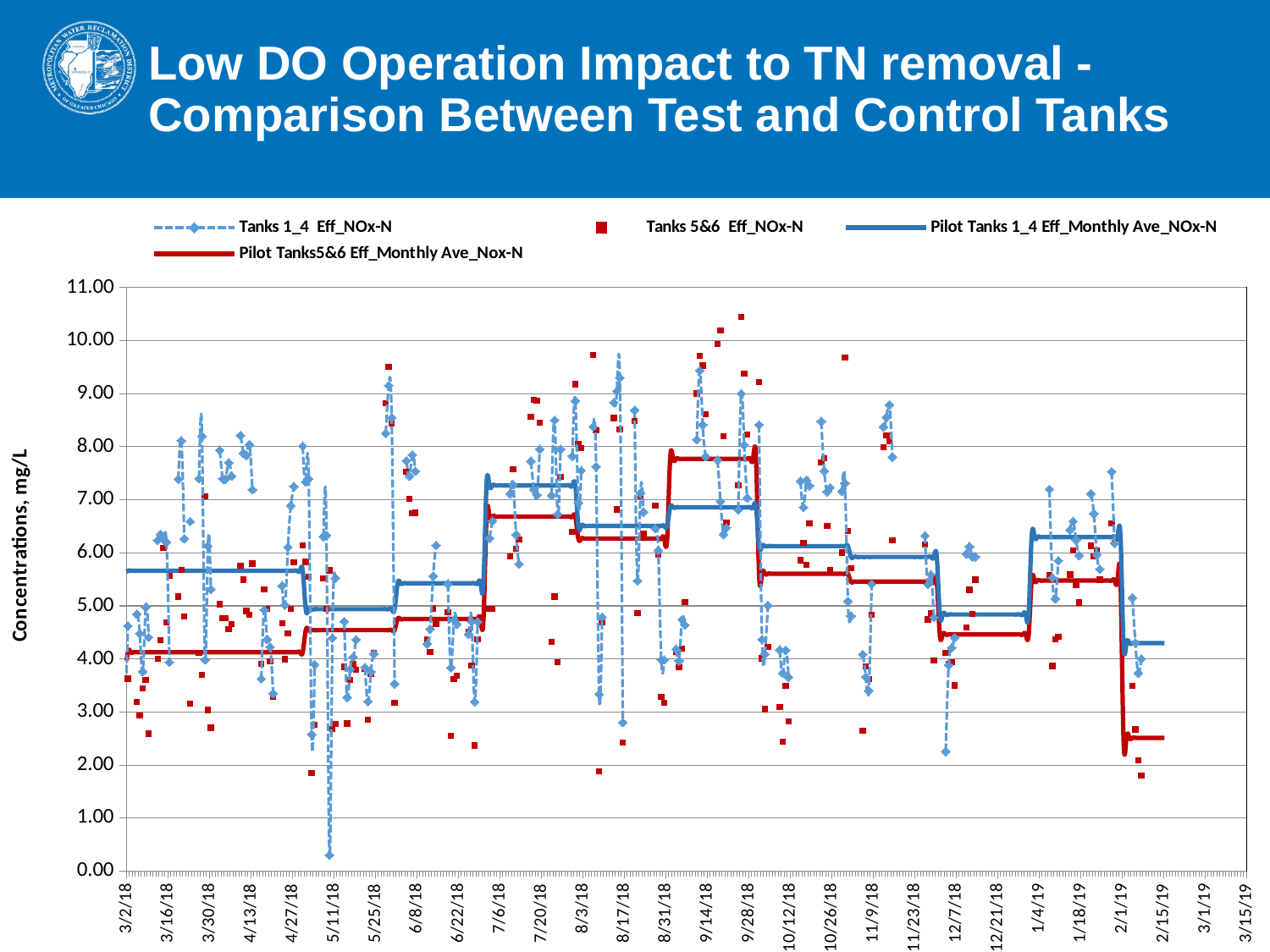
Does the Pilot Tanks5&6 Eff_Monthly Ave_Nox-N line rise or fall from January 2019 to February 2019? fall What type of chart is shown on the slide? line chart How many series does the chart legend list? 4 Is the Pilot Tanks 1_4 Eff_Monthly Ave_NOx-N value in February 2019 greater or less than 5.00? less In September 2018, which monthly average line is higher: Pilot Tanks 1_4 or Pilot Tanks5&6? Pilot Tanks5&6 What is the highest value shown on the vertical axis? 11.00 Is the Pilot Tanks 1_4 Eff_Monthly Ave_NOx-N value in March 2018 greater or less than 5.00? greater Is the Pilot Tanks5&6 Eff_Monthly Ave_Nox-N value in March 2018 greater or less than 5.00? less In March 2018, which monthly average line is higher: Pilot Tanks 1_4 or Pilot Tanks5&6? Pilot Tanks 1_4 What is the label of the vertical axis? Concentrations, mg/L